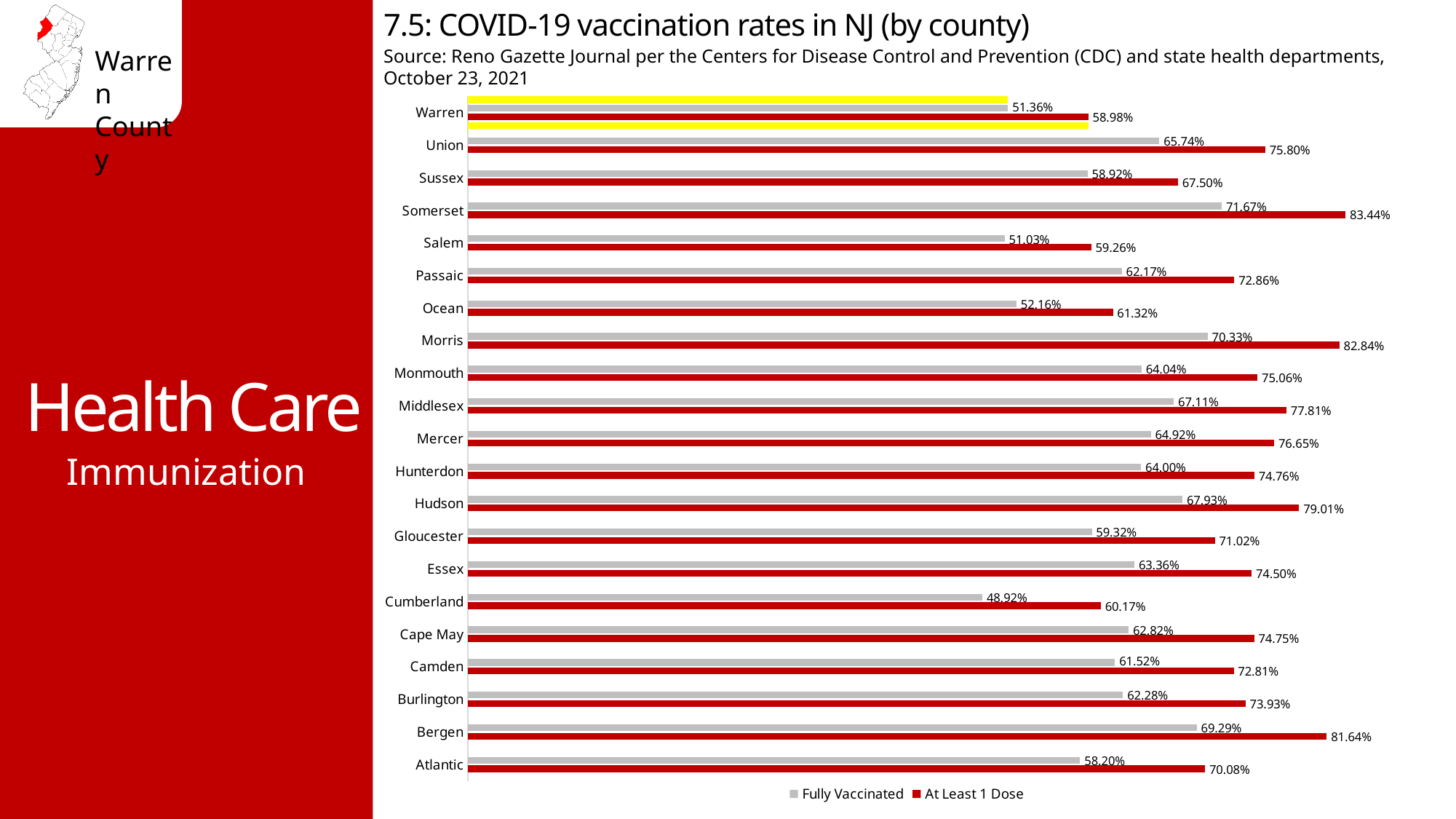
Which county has the higher Fully Vaccinated rate, Union or Sussex? Union How many series does the legend list? 2 What is the Fully Vaccinated rate for Warren county? 51.36% What colour are the At Least 1 Dose bars? Red Which county has the highest Fully Vaccinated rate? Somerset What is the difference between the At Least 1 Dose rate and the Fully Vaccinated rate for Warren county? 7.62 percentage points Which county has the lowest Fully Vaccinated rate? Cumberland What type of chart is shown on the slide? Bar chart Which county has the lowest At Least 1 Dose rate? Warren What is the At Least 1 Dose rate for Cumberland county? 60.17% What is the At Least 1 Dose rate for Somerset county? 83.44% How many counties are shown in the chart? 21